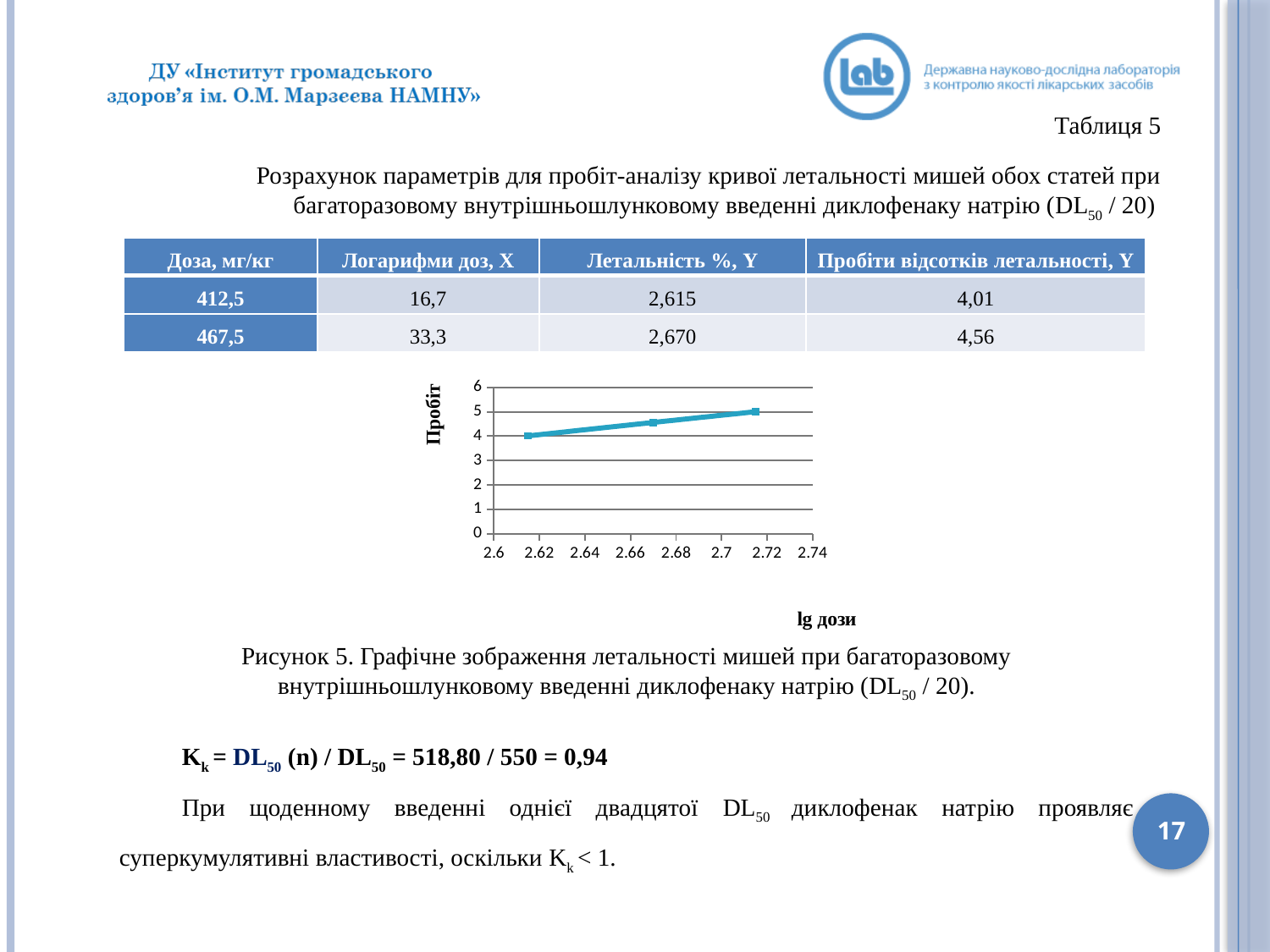
What is the label of the horizontal axis of the chart? lg дози What kind of chart is shown on the slide? line chart Do the probit values rise or fall as lg of dose increases along the x axis? rise What is the label of the vertical axis of the chart? Пробіт Is the probit value of the leftmost point (near lg dose 2.62) greater or less than 3? greater Is the probit value of the leftmost point (near lg dose 2.62) greater or less than 5? less Which point has the highest probit value: the leftmost or the rightmost? the rightmost Is the probit value of the rightmost point (near lg dose 2.72) greater or less than 6? less Which point has the lowest probit value on the chart? the leftmost point (near lg dose 2.62) How many data points are plotted on the line chart? 3 What is the maximum value shown on the vertical axis of the chart? 6